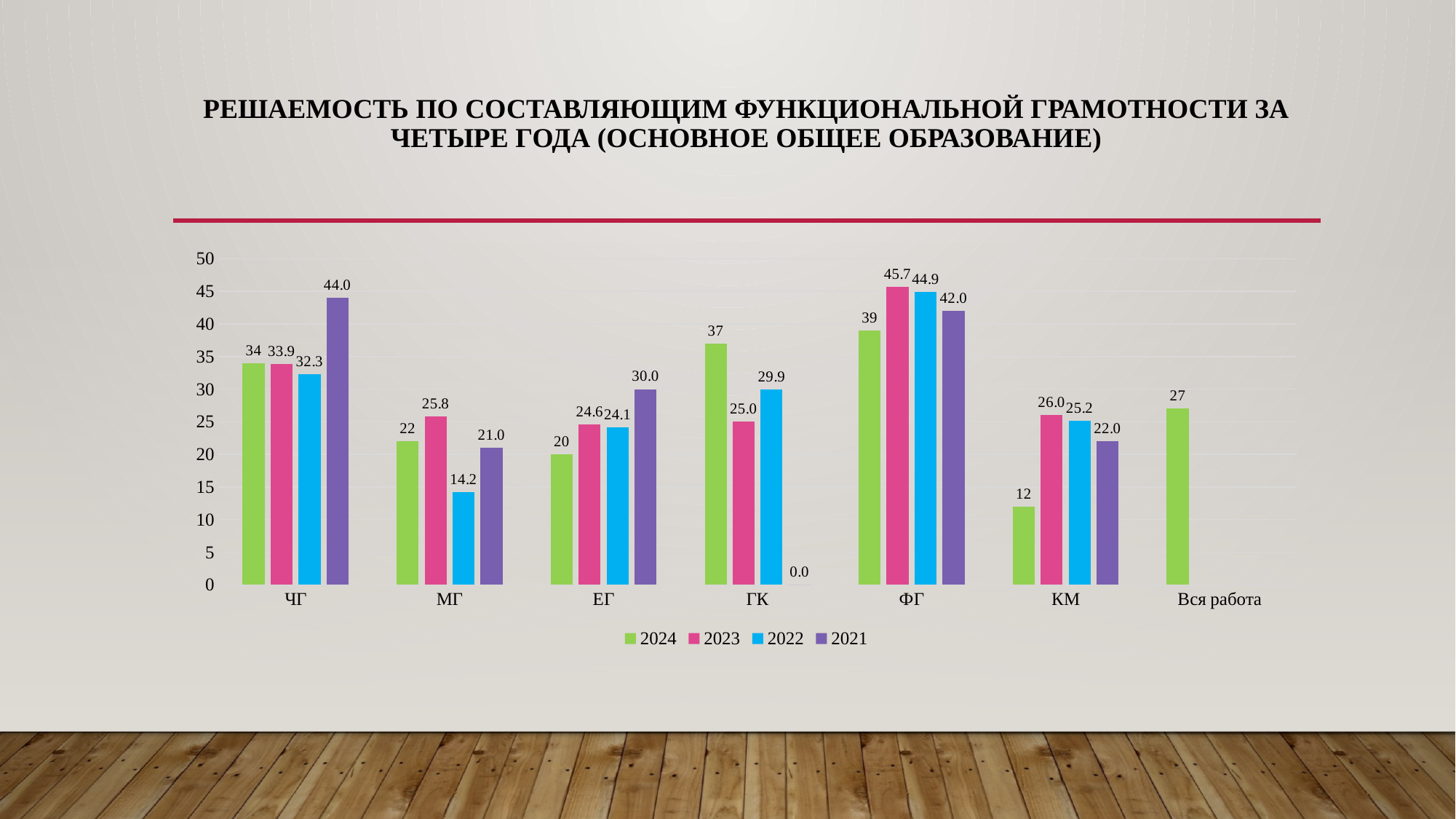
What is the difference between the 2024 and 2023 values for ГК? 12 What is the value for МГ in the 2022 series? 14.2 Which is larger for ЕГ: the 2021 value or the 2024 value? 2021 What kind of chart is shown on the slide? bar chart Which category has the highest value in the 2023 series? ФГ What is the value for ЧГ in the 2021 series? 44.0 How many categories are shown on the x axis? 7 How many series does the legend list? 4 Is the value for ФГ in the 2024 series greater or less than 35? greater What is the value for ГК in the 2021 series? 0.0 What is the value for Вся работа in the 2024 series? 27 Which category has the lowest value in the 2024 series? КМ